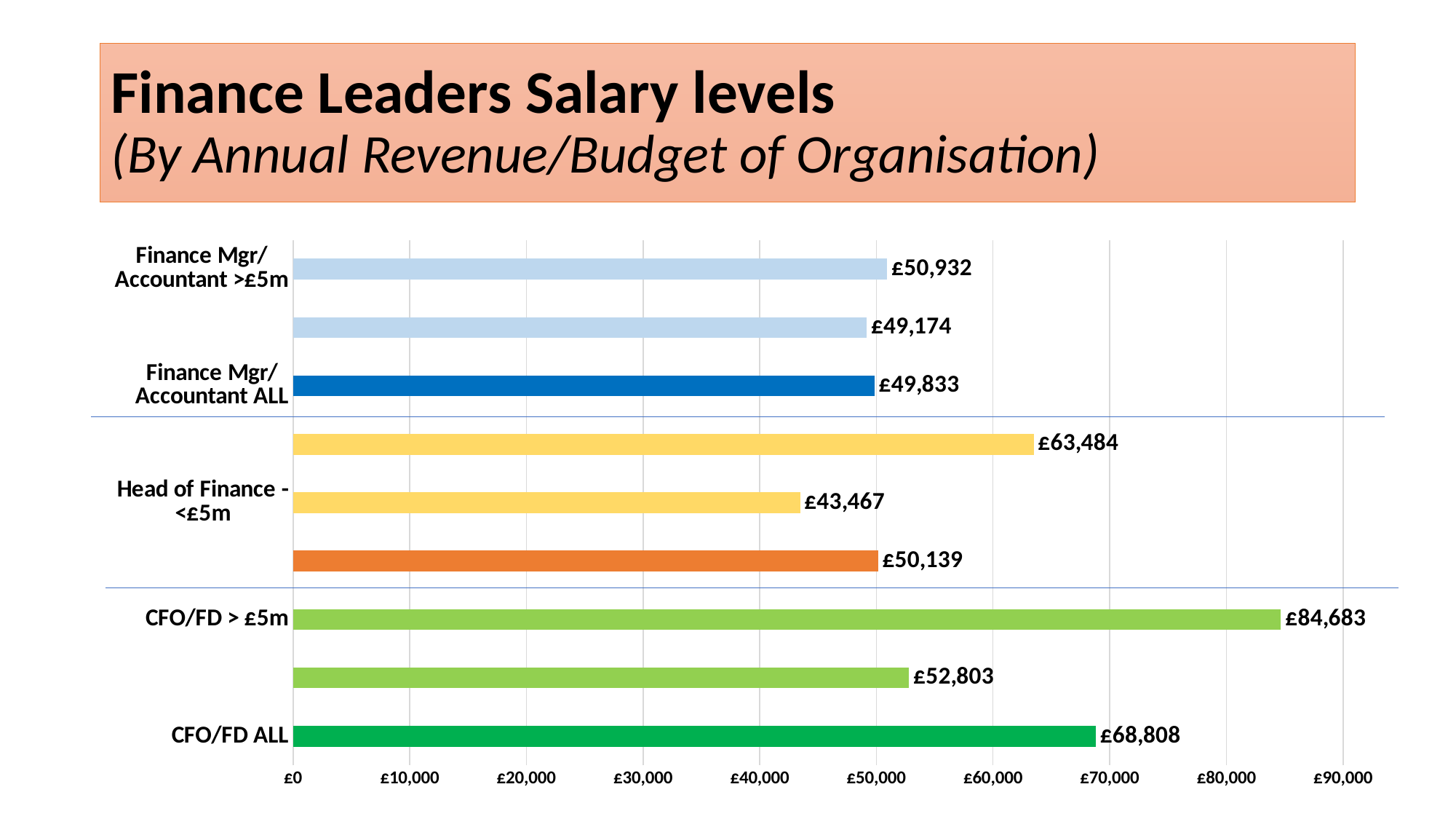
Which is larger, Finance Mgr/Accountant >£5m or Finance Mgr/Accountant ALL? Finance Mgr/Accountant >£5m Which bar has the highest value on the chart? CFO/FD > £5m What is the value for Finance Mgr/Accountant >£5m? £50,932 What type of chart is shown on the slide? Bar chart What is the value for Head of Finance - <£5m? £43,467 Which bar has the lowest value on the chart? Head of Finance - <£5m Is the value for CFO/FD ALL greater or less than £60,000? greater What is the value for CFO/FD > £5m? £84,683 What is the value for Finance Mgr/Accountant ALL? £49,833 How many bars are plotted on the chart? 9 What is the value for CFO/FD ALL? £68,808 What is the difference between CFO/FD > £5m and CFO/FD ALL? £15,875